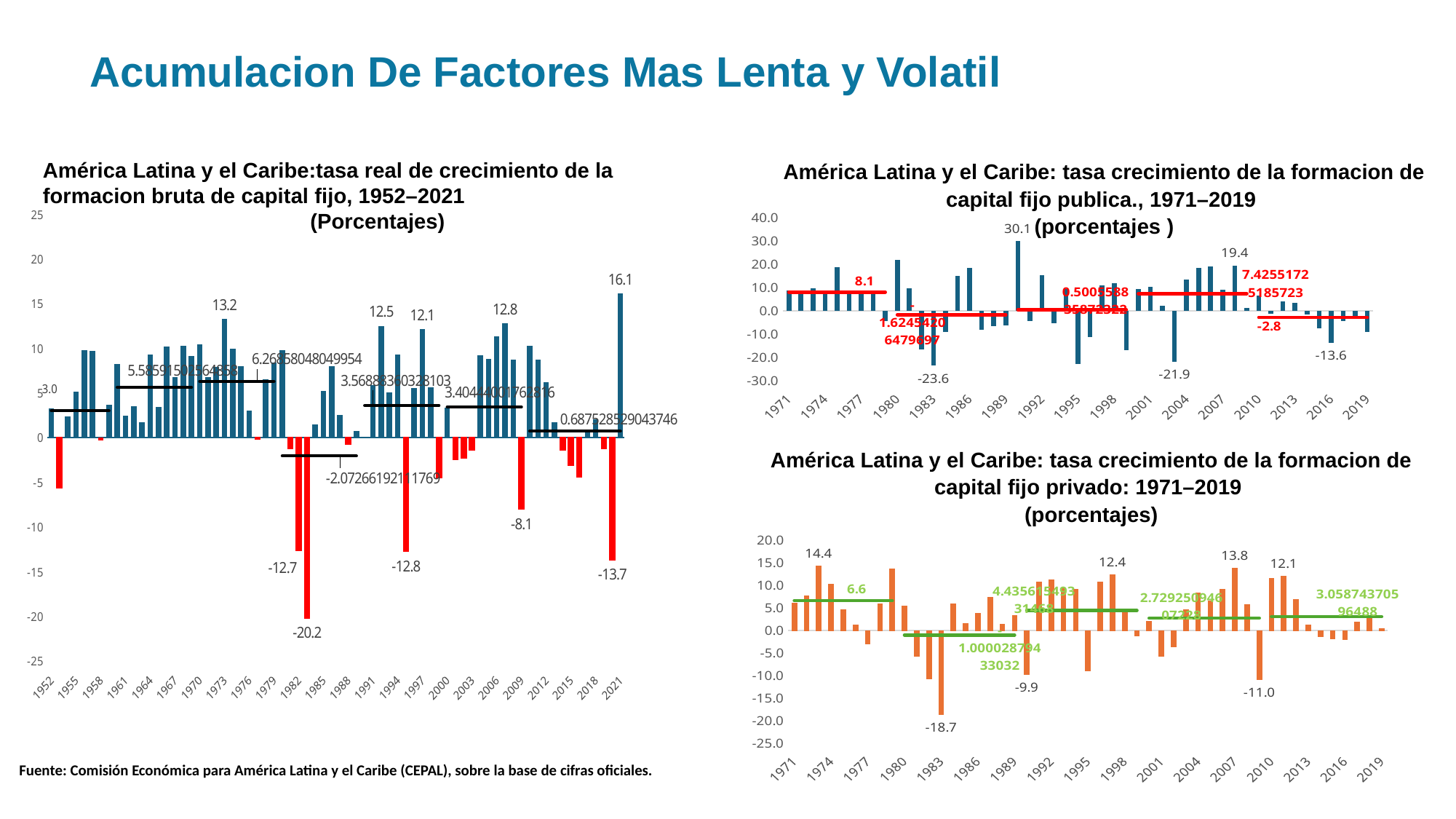
In the top right chart (formacion de capital fijo publica, 1971–2019), what is the value of the first red period-average line, starting in 1971? 8.1 In the bottom right chart (formacion de capital fijo privado, 1971–2019), what is the highest labeled value? 14.4 In the bottom right chart (formacion de capital fijo privado, 1971–2019), what is the lowest labeled value? -18.7 In the left chart (formacion bruta de capital fijo, 1952–2021), what is the highest labeled value? 16.1 In the left chart (formacion bruta de capital fijo, 1952–2021), what is the lowest labeled value? -20.2 In the left chart (formacion bruta de capital fijo, 1952–2021), what is the value of the last bar, for 2021? 16.1 In the top right chart (formacion de capital fijo publica, 1971–2019), what is the lowest labeled value? -23.6 In the top right chart (formacion de capital fijo publica, 1971–2019), what is the highest labeled value? 30.1 What kind of chart is the left chart, 'tasa real de crecimiento de la formacion bruta de capital fijo, 1952–2021'? bar chart How many charts are shown on the slide? 3 In the top right chart (formacion de capital fijo publica, 1971–2019), what is the value of the last red period-average line? -2.8 In the bottom right chart (formacion de capital fijo privado, 1971–2019), what is the difference between the labeled peaks 14.4 and 13.8? 0.6